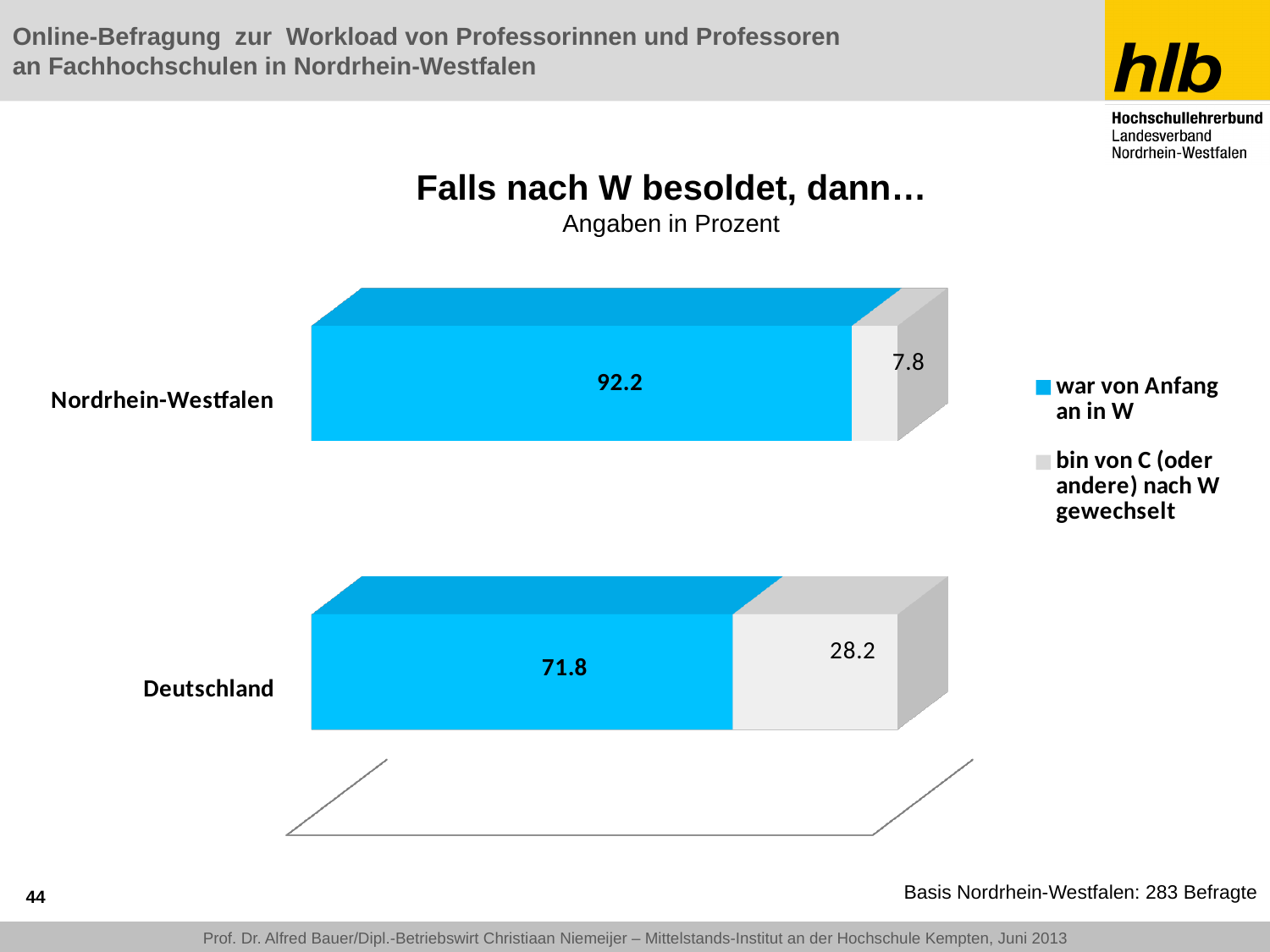
How many series does the legend list? 2 What is the value for "bin von C (oder andere) nach W gewechselt" for Nordrhein-Westfalen? 7.8 What is the value for "war von Anfang an in W" for Nordrhein-Westfalen? 92.2 What is the total of the stacked bar for Deutschland? 100 Is the "bin von C (oder andere) nach W gewechselt" value larger for Deutschland or for Nordrhein-Westfalen? Deutschland Which category has the lower value for "bin von C (oder andere) nach W gewechselt"? Nordrhein-Westfalen How many categories are shown in the chart? 2 What is the difference between the "war von Anfang an in W" values for Nordrhein-Westfalen and Deutschland? 20.4 What is the value for "war von Anfang an in W" for Deutschland? 71.8 Which category has the higher value for "war von Anfang an in W"? Nordrhein-Westfalen What is the value for "bin von C (oder andere) nach W gewechselt" for Deutschland? 28.2 What kind of chart is shown on the slide? Stacked bar chart